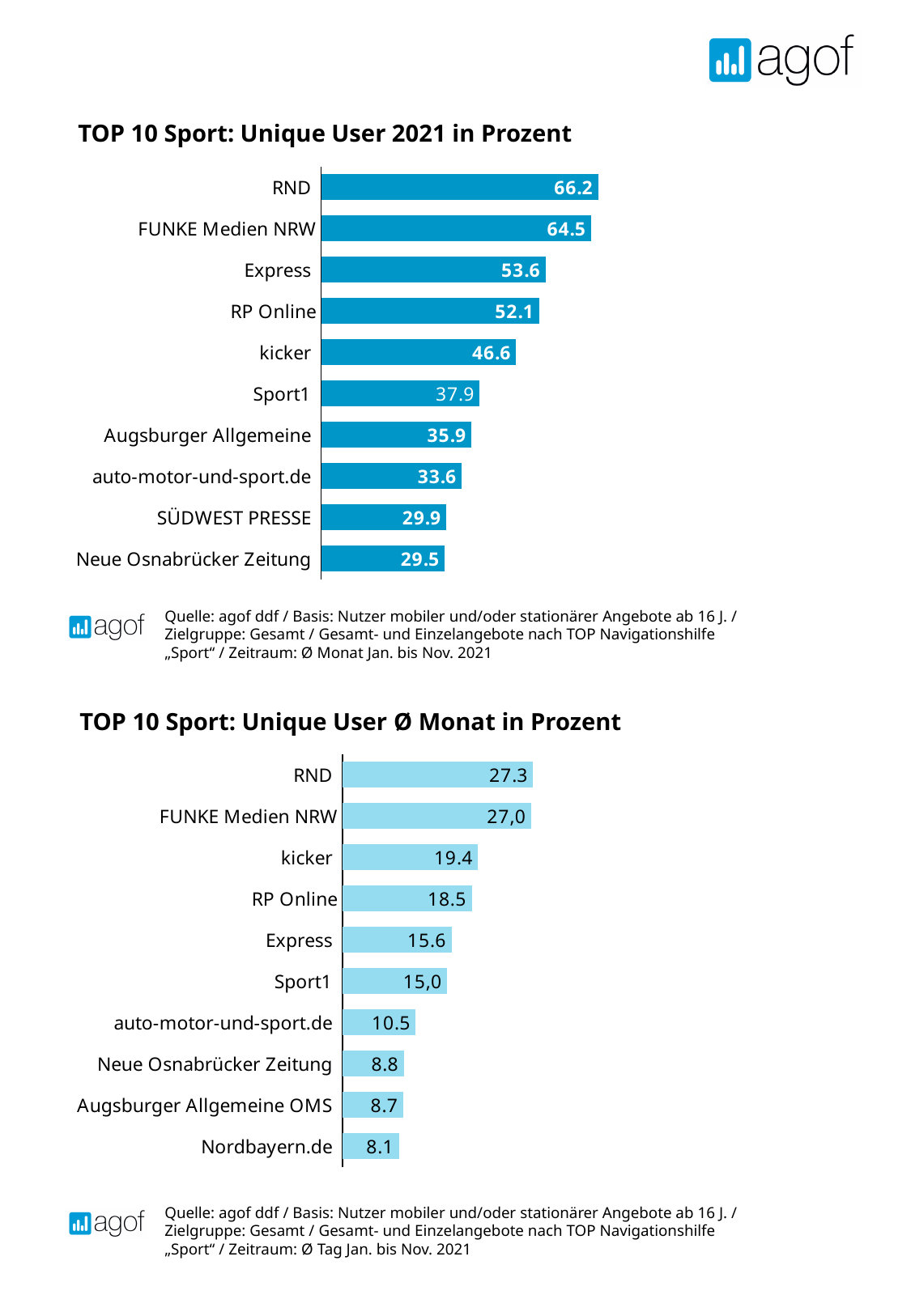
In the chart 'TOP 10 Sport: Unique User Ø Monat in Prozent', what is the value for kicker? 19.4 In the chart 'TOP 10 Sport: Unique User 2021 in Prozent', which category has the lowest value? Neue Osnabrücker Zeitung In the chart 'TOP 10 Sport: Unique User 2021 in Prozent', how many categories are shown? 10 In the chart 'TOP 10 Sport: Unique User 2021 in Prozent', what is the value for kicker? 46.6 In the chart 'TOP 10 Sport: Unique User 2021 in Prozent', what is the difference between RND and FUNKE Medien NRW? 1.7 In the chart 'TOP 10 Sport: Unique User 2021 in Prozent', what is the value for RND? 66.2 What kind of chart is 'TOP 10 Sport: Unique User Ø Monat in Prozent'? Bar chart In the chart 'TOP 10 Sport: Unique User Ø Monat in Prozent', do the values rise or fall from top to bottom? Fall In the chart 'TOP 10 Sport: Unique User Ø Monat in Prozent', what is the value for Nordbayern.de? 8.1 In the chart 'TOP 10 Sport: Unique User Ø Monat in Prozent', which category has the highest value? RND In the chart 'TOP 10 Sport: Unique User 2021 in Prozent', which is larger, Express or RP Online? Express In the chart 'TOP 10 Sport: Unique User Ø Monat in Prozent', what is the difference between RP Online and Express? 2.9